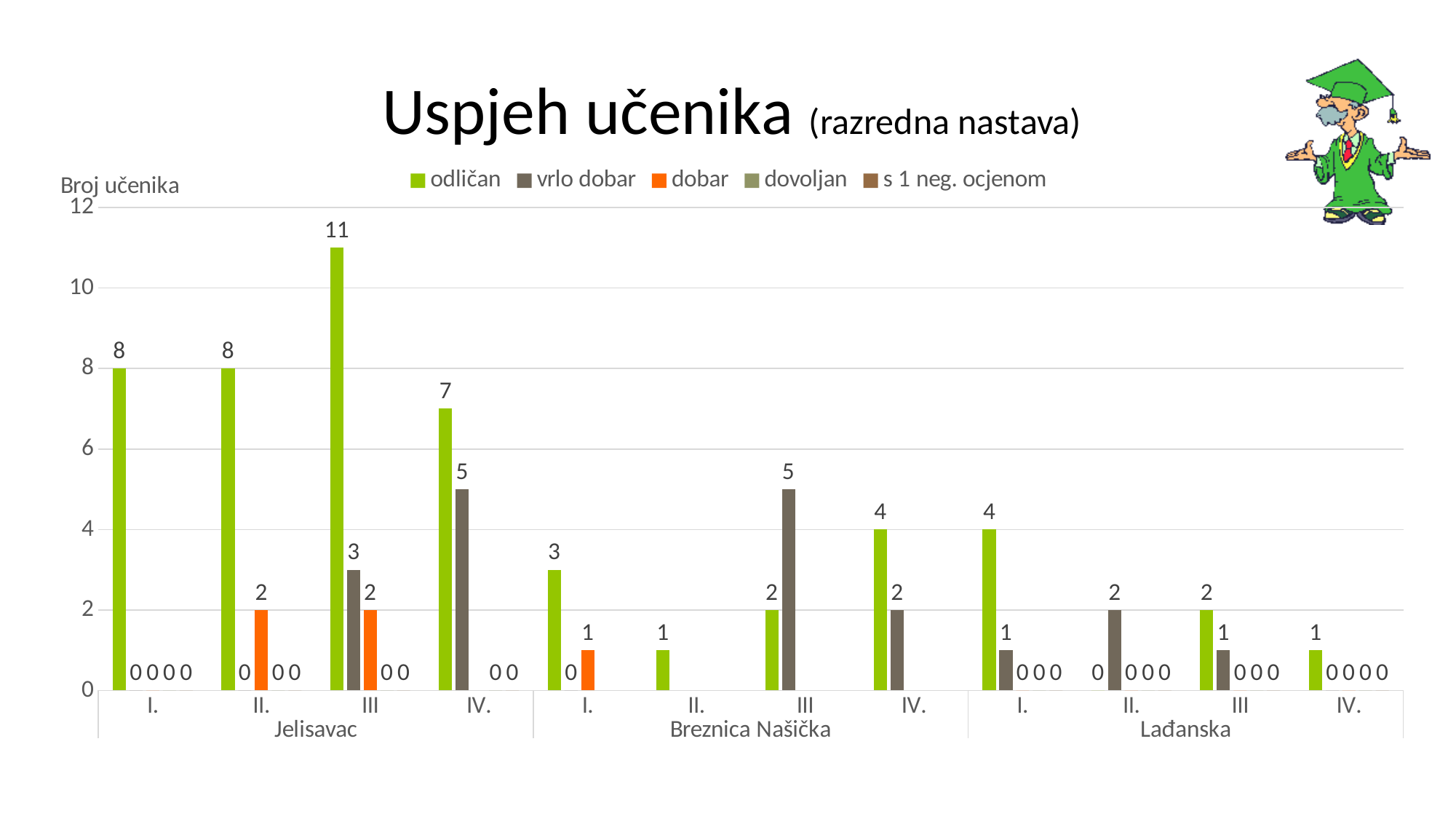
What is the value of 'dobar' for class I. in Breznica Našička? 1 What is the difference between the 'odličan' values for class III and class IV. in Jelisavac? 4 What is the value of 'vrlo dobar' for class III in Breznica Našička? 5 What kind of chart is shown on the slide? bar chart How many class categories are shown along the x axis in total? 12 How many series does the legend list? 5 What is the value of 'vrlo dobar' for class IV. in Jelisavac? 5 Which class and school has the highest 'odličan' value? III, Jelisavac What is the value of 'vrlo dobar' for class II. in Lađanska? 2 Which is larger: 'odličan' for class IV. in Breznica Našička or 'odličan' for class I. in Breznica Našička? class IV. in Breznica Našička What is the value of 'odličan' for class III in Jelisavac? 11 What is the label of the vertical axis? Broj učenika